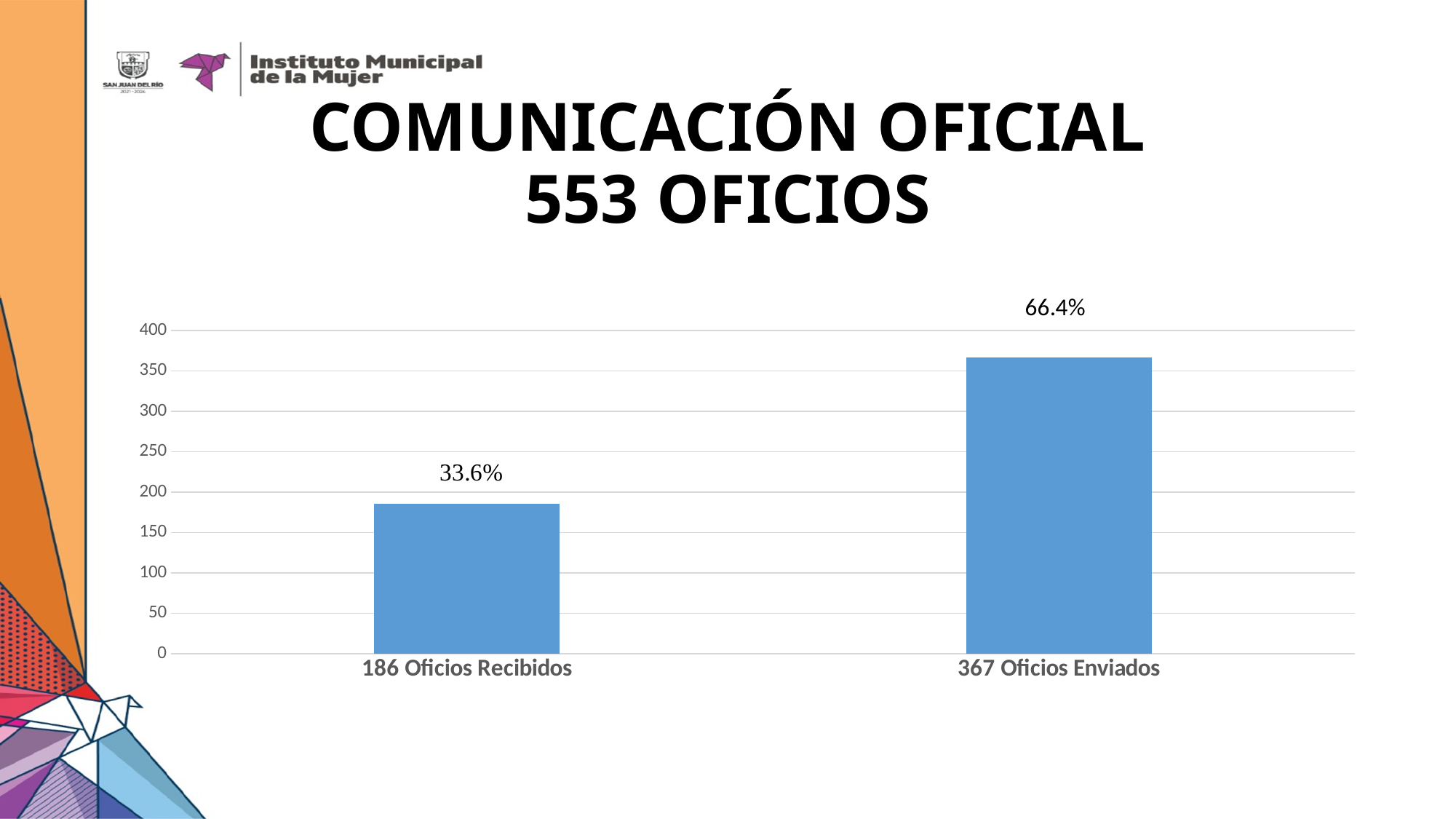
How many oficios were received according to the category label? 186 Is the bar for Oficios Enviados taller or shorter than the bar for Oficios Recibidos? taller What is the difference between the number of Oficios Enviados (367) and Oficios Recibidos (186)? 181 What percentage label is shown above the bar for Oficios Enviados? 66.4% What is the highest value shown on the vertical axis? 400 What kind of chart is shown on the slide? bar chart Which category has the shorter bar? 186 Oficios Recibidos Is the value for Oficios Enviados greater or less than 350? greater What percentage label is shown above the bar for Oficios Recibidos? 33.6% How many bars are plotted in the chart? 2 Which category has the taller bar? 367 Oficios Enviados Is the value for Oficios Recibidos greater or less than 200? less